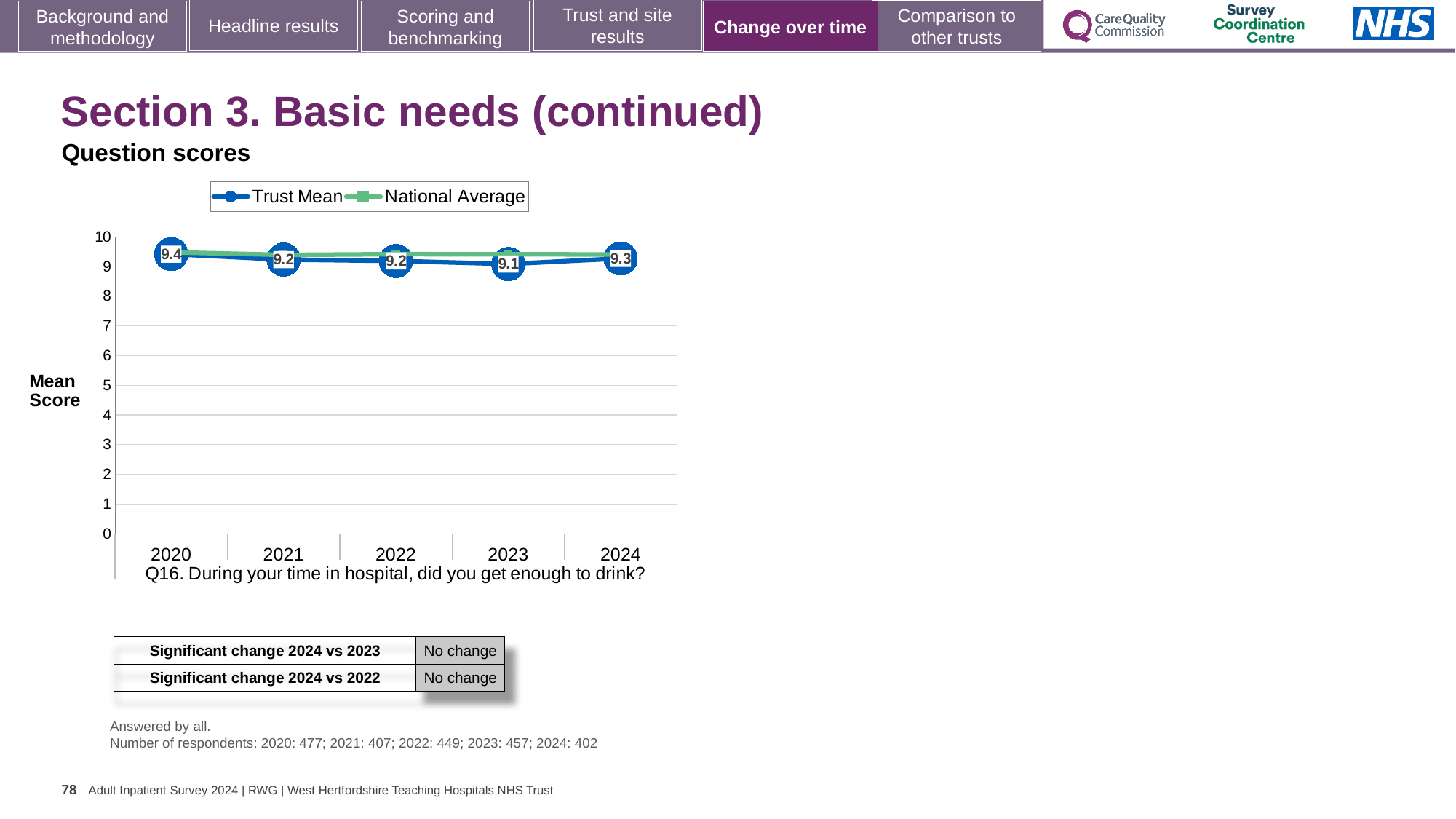
What is the difference between the Trust Mean scores for 2020 and 2023? 0.3 Which year has the larger Trust Mean score, 2021 or 2024? 2024 Is the National Average value for 2022 greater or less than 5? greater What is the Trust Mean score for 2023? 9.1 What is the Trust Mean score for 2024? 9.3 Which survey question does the chart show scores for? Q16. During your time in hospital, did you get enough to drink? What kind of chart is shown on the slide? Line chart What is the Trust Mean score for 2020? 9.4 How many series does the legend list? 2 In which year is the Trust Mean score lowest? 2023 How many years are plotted on the x axis? 5 In which year is the Trust Mean score highest? 2020